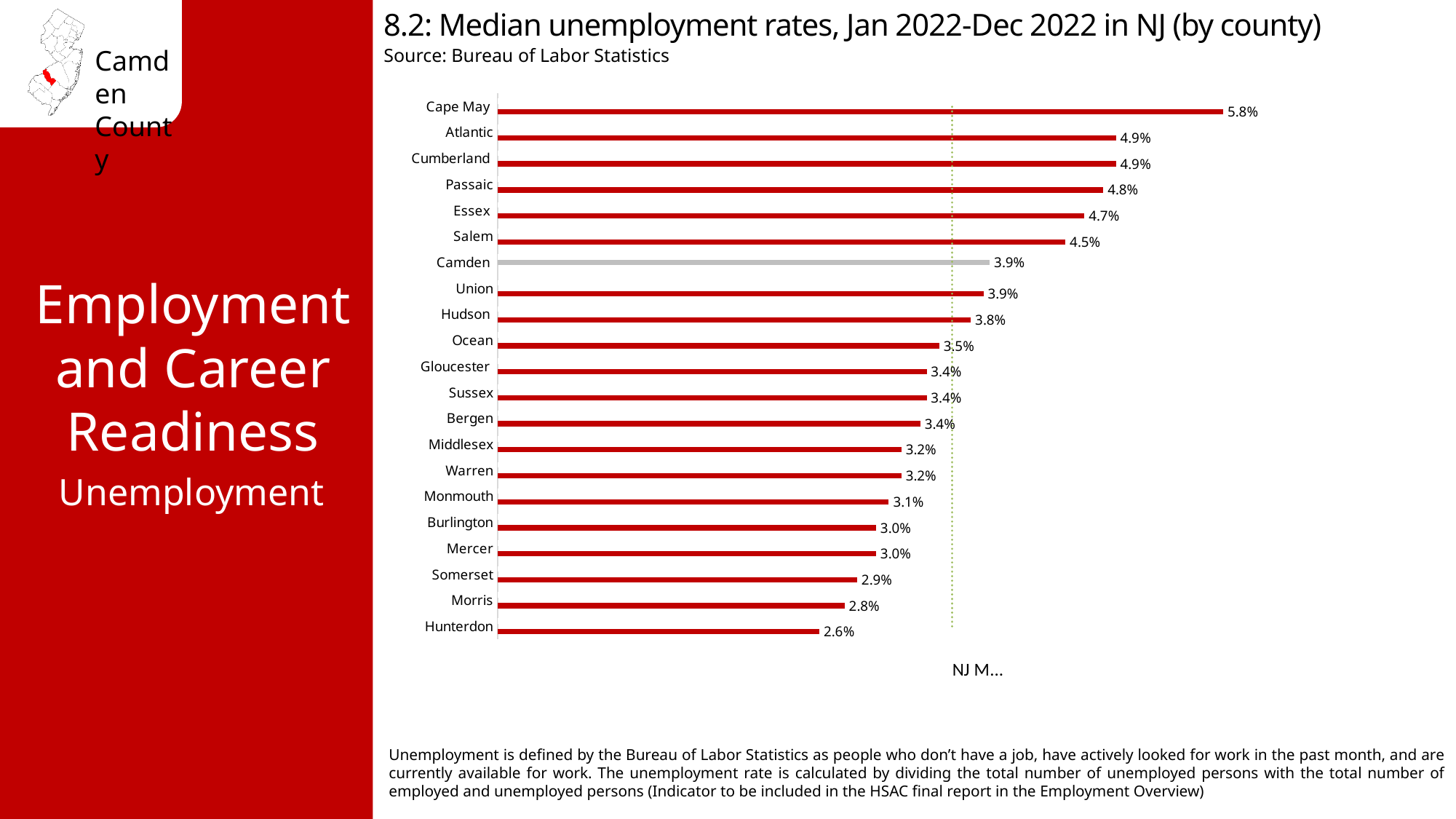
What is the median unemployment rate for Camden? 3.9% How many counties are shown in the chart? 21 What is the difference between the median unemployment rates of Cape May and Hunterdon? 3.2% Which county has the highest median unemployment rate? Cape May Which county's bar is shown in grey rather than red? Camden What is the difference between the median unemployment rates of Passaic and Camden? 0.9% What is the median unemployment rate for Salem? 4.5% Which county has a higher median unemployment rate, Essex or Morris? Essex Which county has the lowest median unemployment rate? Hunterdon What type of chart is used to show the median unemployment rates? Bar chart What is the median unemployment rate for Hunterdon? 2.6% What is the median unemployment rate for Cape May? 5.8%